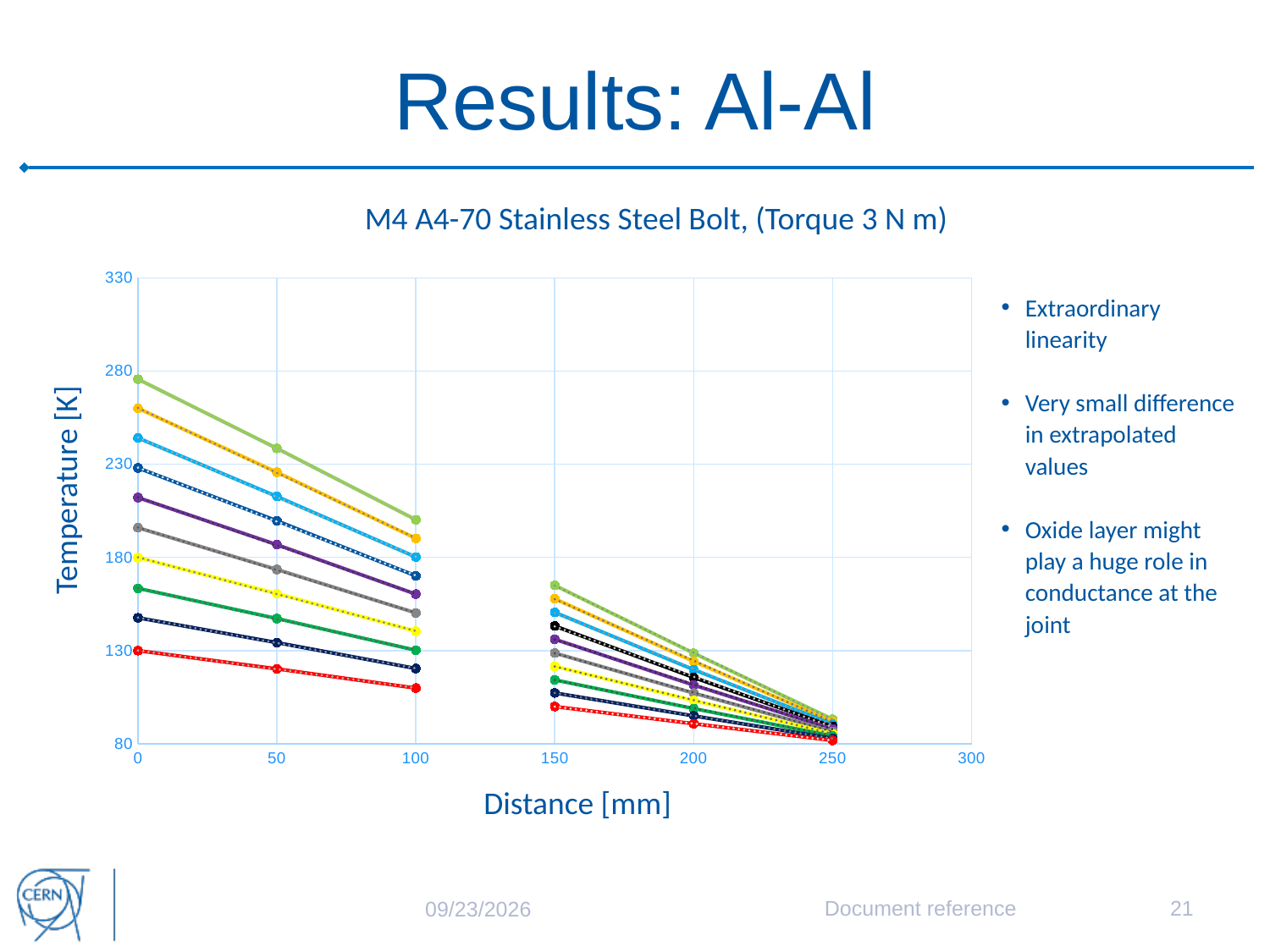
Is the value of the light green series at 0 mm greater or less than 230? greater Is the value of the orange series at 0 mm greater or less than 230? greater What is the title of the chart? M4 A4-70 Stainless Steel Bolt, (Torque 3 N m) Is the value of the light green series at 100 mm greater or less than 180? greater At 0 mm, which is larger: the value of the light green series or the value of the red series? the light green series Do the temperature values rise or fall as distance increases along the x axis? fall What kind of chart is shown on the slide? line chart Which series has the lowest temperature at 0 mm? the red series Which series has the highest temperature at 0 mm? the light green series What is the label of the vertical axis of the chart? Temperature [K]